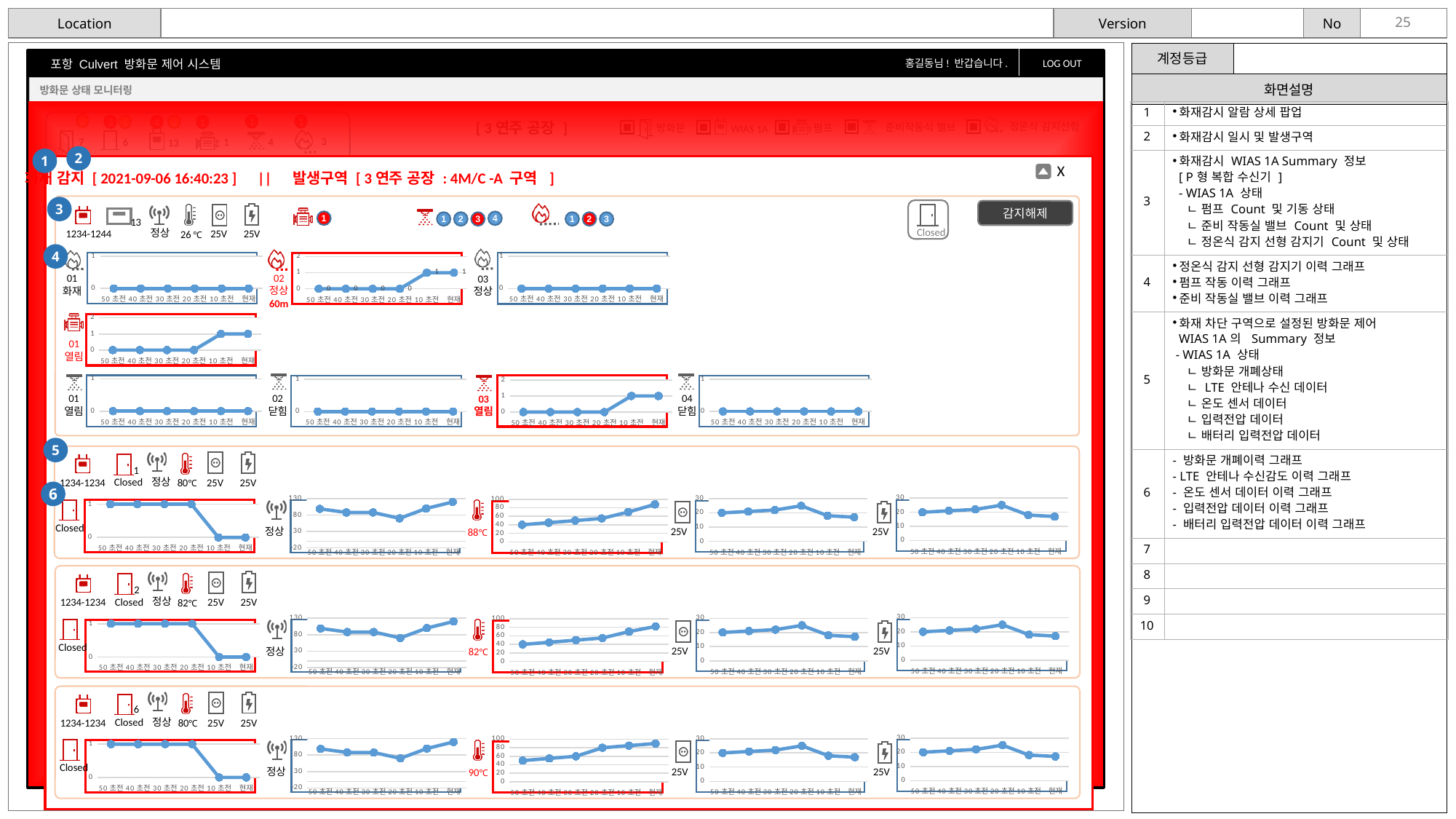
What is the highest y-axis tick shown on the temperature history charts? 100 In the pump chart labelled "01 열림" (second row, left), is the value at 현재 greater or less than 2? less In the temperature chart labelled 88℃ in the first WIAS 1A panel, is the value at 현재 greater or less than 60? greater In the sprinkler chart labelled "03 열림" (third row), is the value at 50 초전 greater or less than 1? less In the chart labelled "02 정상 60m" (top row, middle), what is the value at 현재? 1 What kind of chart is used for the history graphs in the fire-detection popup? line chart In the temperature chart labelled 88℃ in the first WIAS 1A panel, do the values rise or fall moving toward 현재? rise In the chart labelled "02 정상 60m" (top row, middle), do the values rise or fall moving toward 현재? rise What is the label at the far right of the x axis on the history charts? 현재 In the chart labelled "02 정상 60m" (top row, middle), what is the value at 50 초전? 0 In the "Closed" door-status chart of the first WIAS 1A panel (next to marker 6), do the values rise or fall moving toward 현재? fall